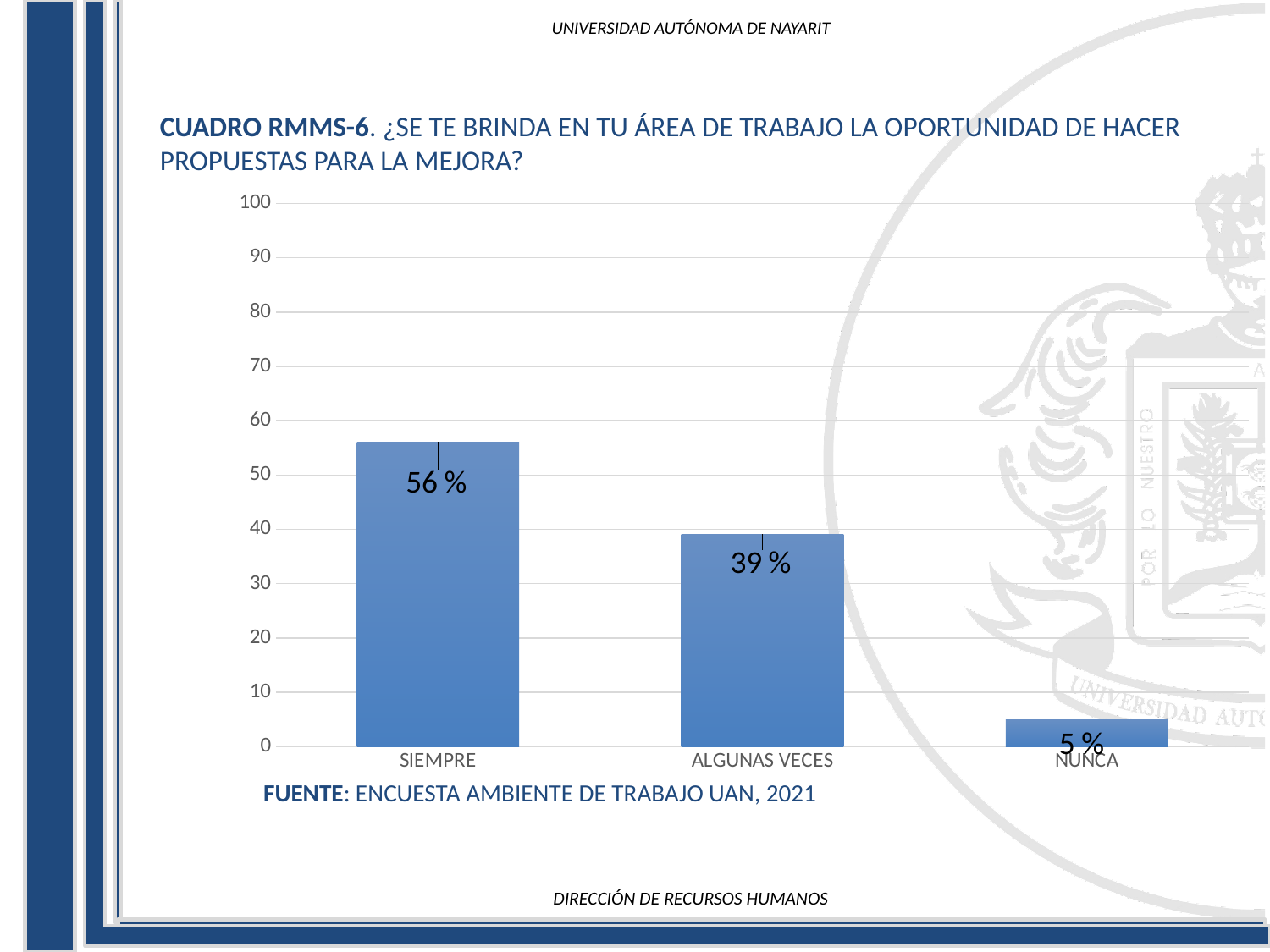
Is the value for SIEMPRE greater or less than 50? greater What is the difference between the values for ALGUNAS VECES and NUNCA? 34 % Which category has the highest value? SIEMPRE Which category has the lowest value? NUNCA How many categories are shown on the x axis? 3 What is the value for ALGUNAS VECES? 39 % What is the difference between the values for SIEMPRE and ALGUNAS VECES? 17 % What kind of chart is shown on the slide? bar chart What source is cited below the chart? ENCUESTA AMBIENTE DE TRABAJO UAN, 2021 What is the value for NUNCA? 5 % What is the value for SIEMPRE? 56 % Which is larger, the value for ALGUNAS VECES or the value for NUNCA? ALGUNAS VECES